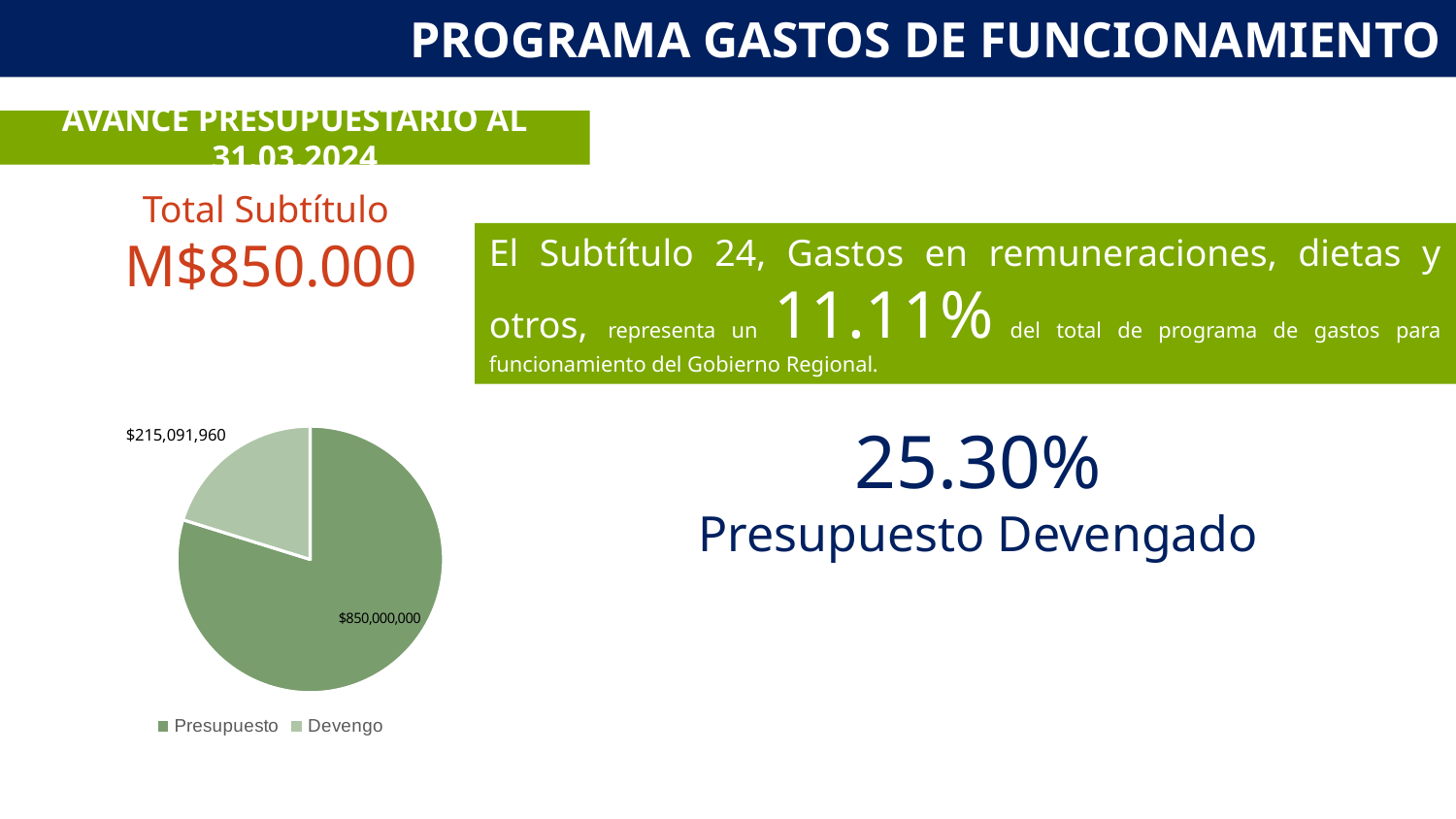
What is the difference between the Presupuesto value and the Devengo value in the pie chart? $634,908,040 How many slices does the pie chart have? 2 What are the legend entries of the pie chart? Presupuesto, Devengo Which legend entry of the pie chart is shown in the darker green? Presupuesto What kind of chart is shown on the slide? pie chart What is the value shown for Presupuesto in the pie chart? $850,000,000 Which slice of the pie chart is the largest? Presupuesto How many entries does the pie chart legend list? 2 What is the value shown for Devengo in the pie chart? $215,091,960 Which slice of the pie chart is the smallest? Devengo Which is larger in the pie chart, Presupuesto or Devengo? Presupuesto